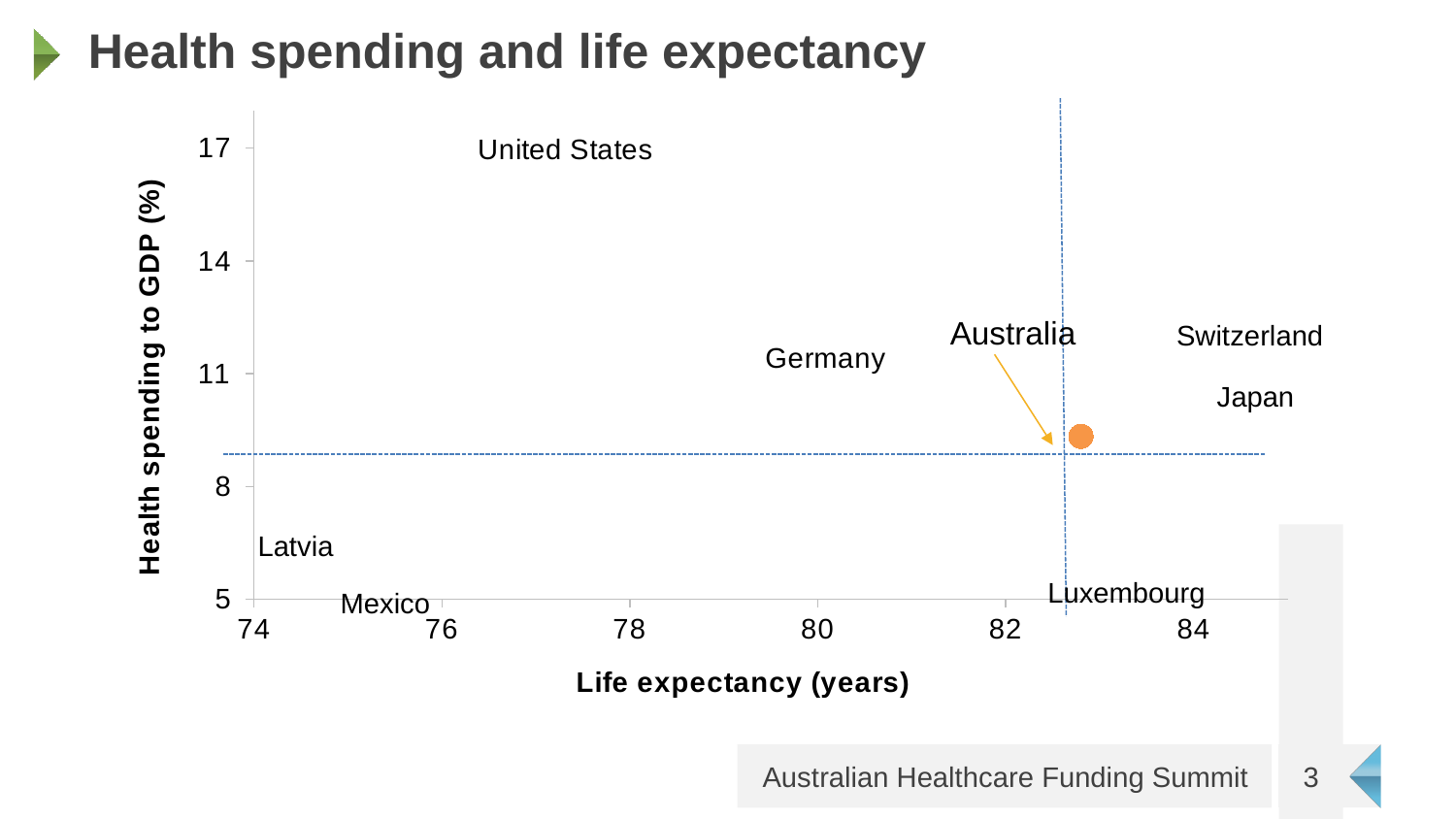
What kind of chart is shown on the slide? Scatter chart Which has higher life expectancy, Australia or Mexico? Australia Is the health spending to GDP value for Latvia greater or less than 8? less How many countries are labelled on the chart? 8 Is the health spending to GDP value for Australia greater or less than 11? less What is the label of the horizontal axis? Life expectancy (years) Which country has the highest health spending to GDP? United States What is the title of the chart? Health spending and life expectancy Is the health spending to GDP value for the United States greater or less than 14? greater Which country has the lowest life expectancy? Latvia Which has higher health spending to GDP, Germany or Latvia? Germany